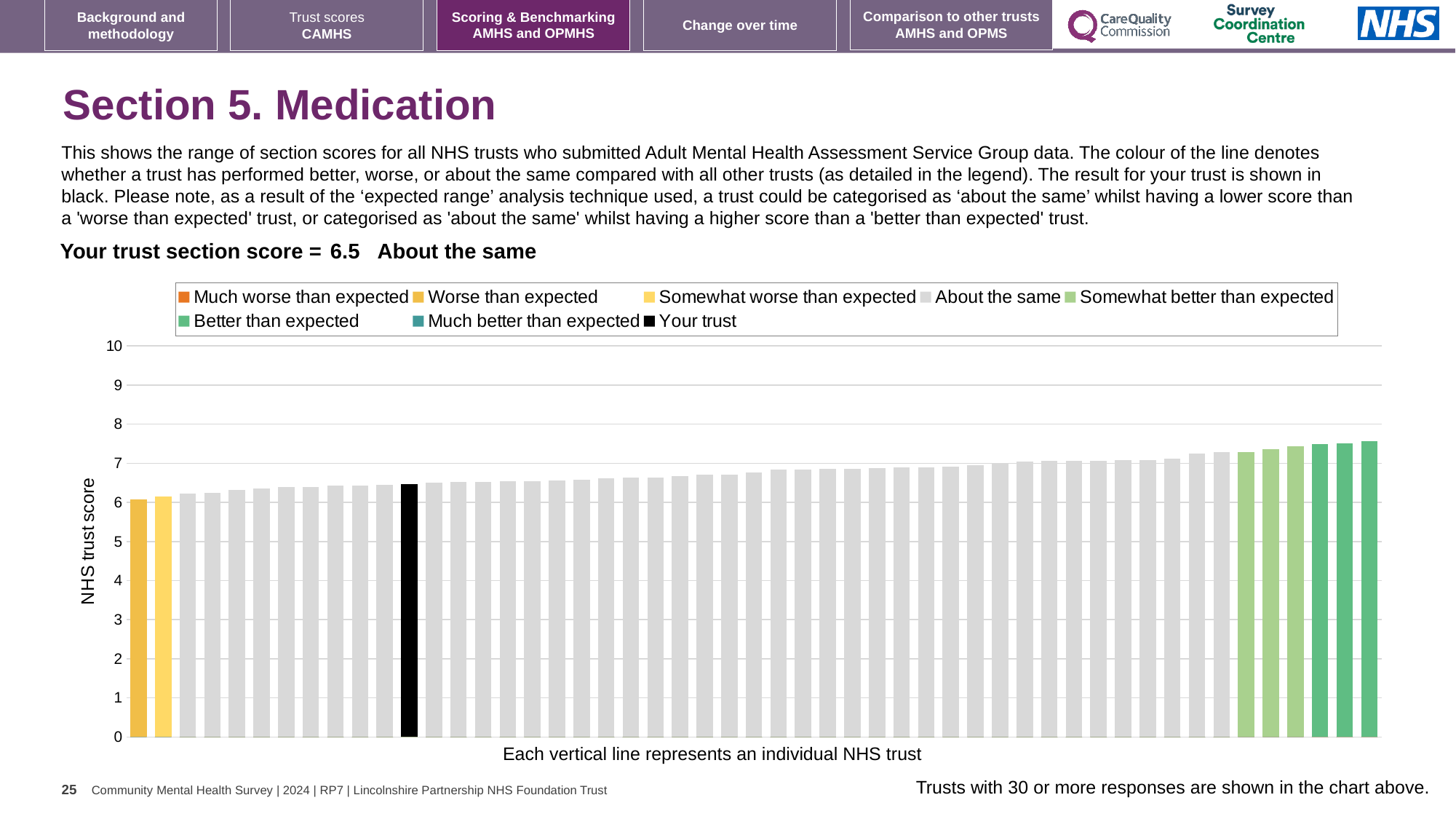
What is the maximum value shown on the vertical axis? 10 Is the value of the tallest bar greater or less than 8? less What is the label on the vertical axis of the chart? NHS trust score What colour is the bar representing your trust? black Which category is your trust placed in for this section? About the same What kind of chart is shown on the slide? bar chart Do the bar values rise or fall from left to right along the x axis? rise Is the value of the black bar (your trust) greater or less than 5? greater What is the section score for your trust shown on the slide? 6.5 How many entries does the chart legend list? 8 Is the value of the shortest bar greater or less than 5? greater